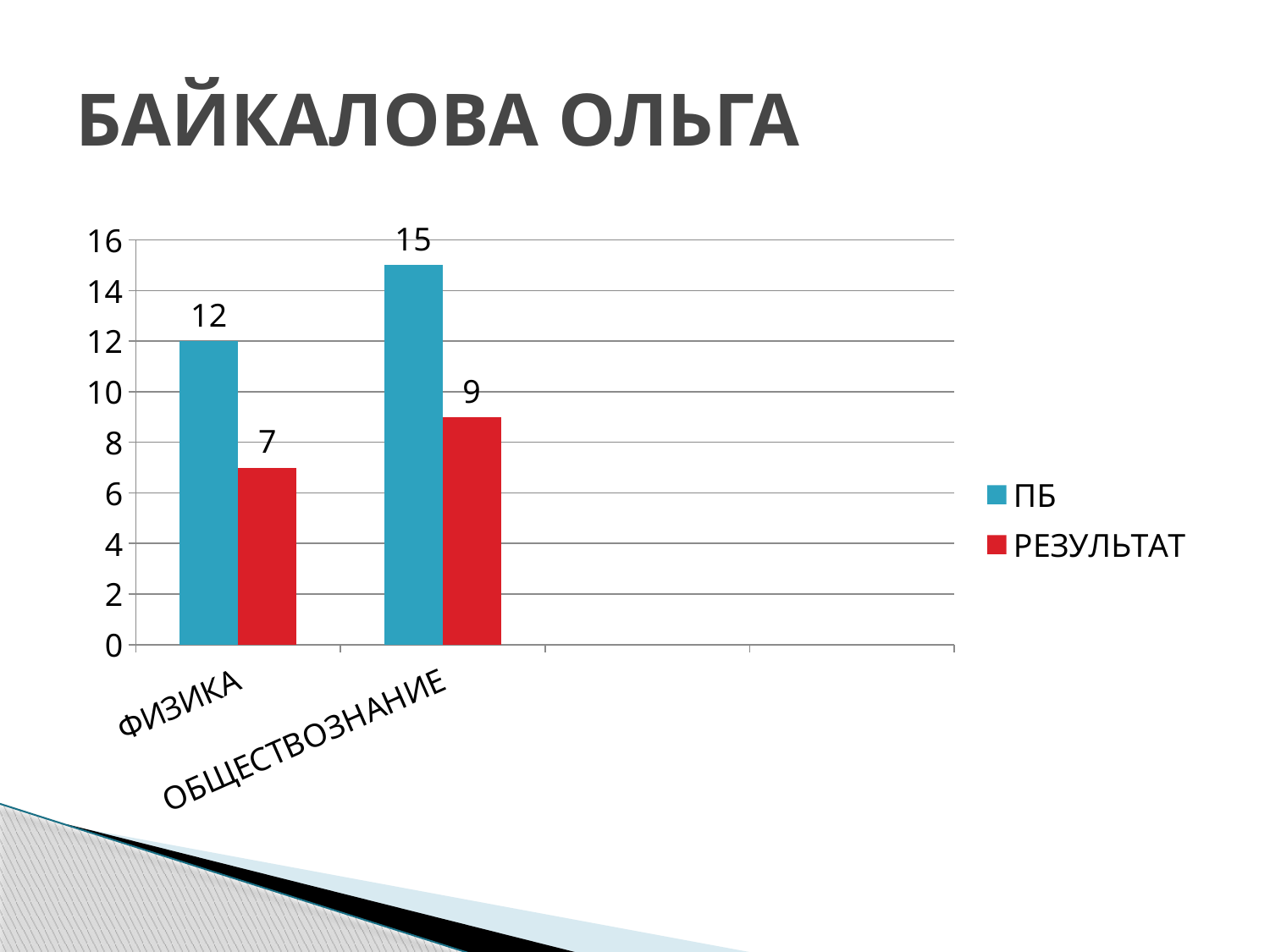
What is the РЕЗУЛЬТАТ value for ФИЗИКА? 7 What colour are the РЕЗУЛЬТАТ bars? red What kind of chart is shown on the slide? bar chart What is the ПБ value for ФИЗИКА? 12 How many categories are shown on the x axis? 2 Which category has the highest ПБ value? ОБЩЕСТВОЗНАНИЕ How many series does the legend list? 2 What is the difference between the ПБ values for ОБЩЕСТВОЗНАНИЕ and ФИЗИКА? 3 Which is larger for ФИЗИКА, the ПБ value or the РЕЗУЛЬТАТ value? ПБ Which category has the lowest РЕЗУЛЬТАТ value? ФИЗИКА What is the РЕЗУЛЬТАТ value for ОБЩЕСТВОЗНАНИЕ? 9 What is the difference between the ПБ and РЕЗУЛЬТАТ values for ОБЩЕСТВОЗНАНИЕ? 6